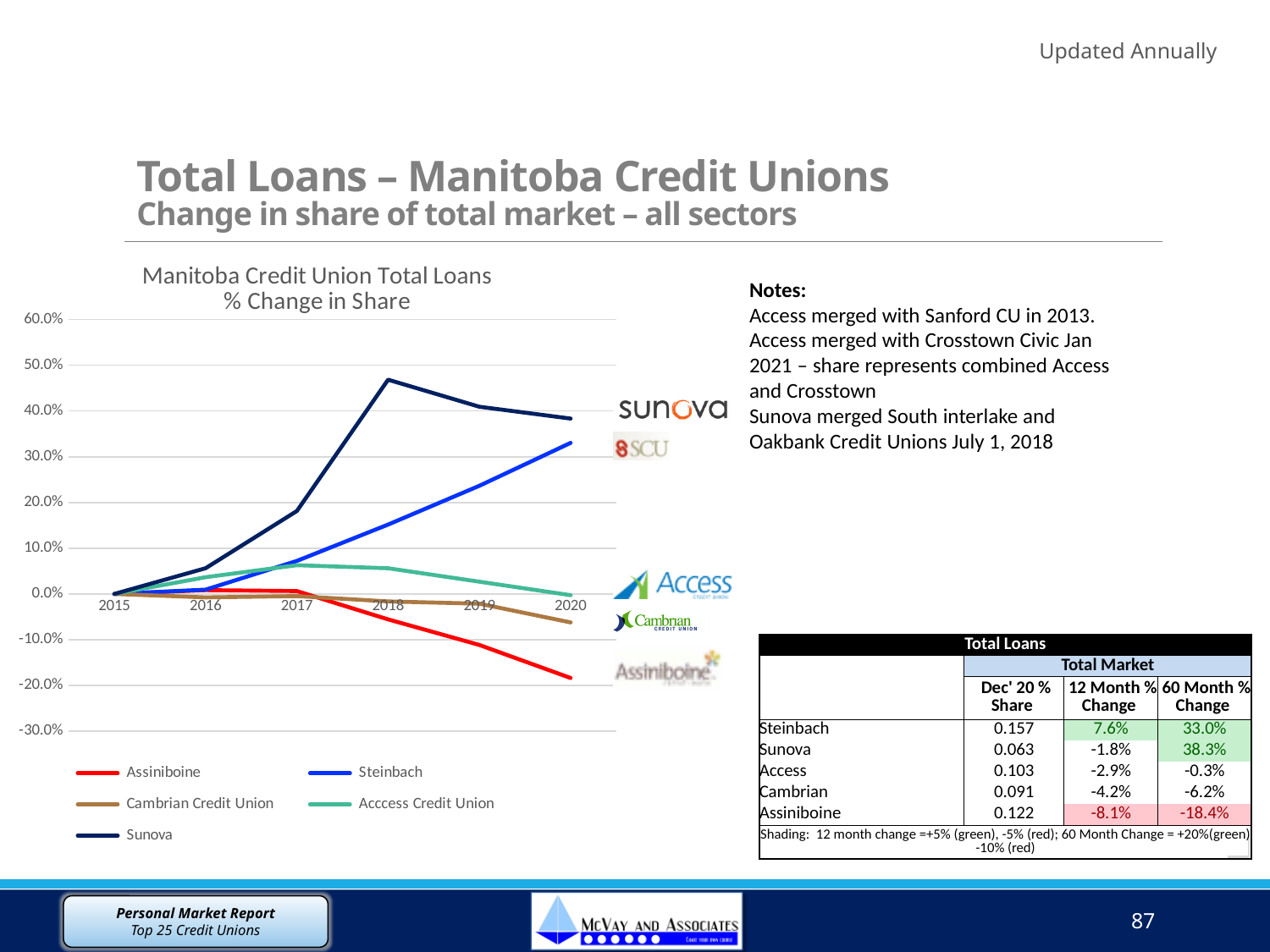
Is the value for Assiniboine in 2020 greater or less than -10.0%? less Which credit union has the highest % change in share in 2020? Sunova What is the title of the chart? Manitoba Credit Union Total Loans % Change in Share How many years are plotted along the x axis of the chart? 6 Which credit union has the lowest % change in share in 2020? Assiniboine Does the Steinbach line rise or fall from 2015 to 2020? Rises What kind of chart is shown on the slide? Line chart How many series does the chart legend list? 5 In 2018, which is larger: the value for Sunova or the value for Steinbach? Sunova Is the value for Sunova in 2018 greater or less than 40.0%? greater Does the Assiniboine line rise or fall from 2017 to 2020? Falls Is the value for Steinbach in 2020 greater or less than 30.0%? greater